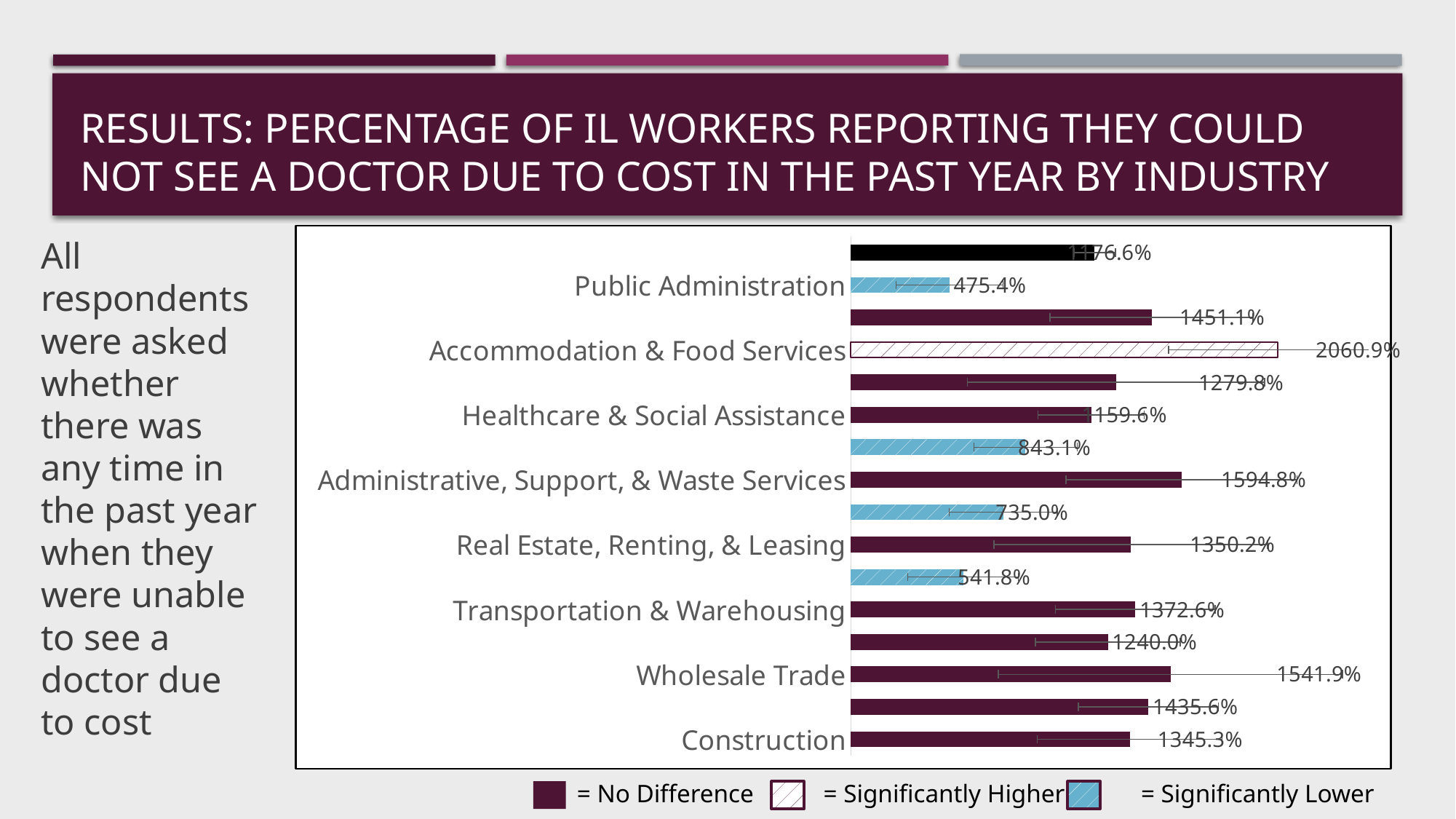
According to the legend, what does a hatched (white with diagonal lines) bar represent? Significantly Higher Which labeled industry has the longest bar in the chart? Accommodation & Food Services How many entries does the chart legend list? 3 How many industry labels are readable on the chart's category axis? 8 What kind of chart is shown on the slide? bar chart Which has the longer bar, Accommodation & Food Services or Construction? Accommodation & Food Services Which has the longer bar, Healthcare & Social Assistance or Public Administration? Healthcare & Social Assistance Which labeled industry has the shortest bar in the chart? Public Administration Which labeled industry is shown with a blue bar, indicating Significantly Lower? Public Administration Which has the longer bar, Accommodation & Food Services or Public Administration? Accommodation & Food Services